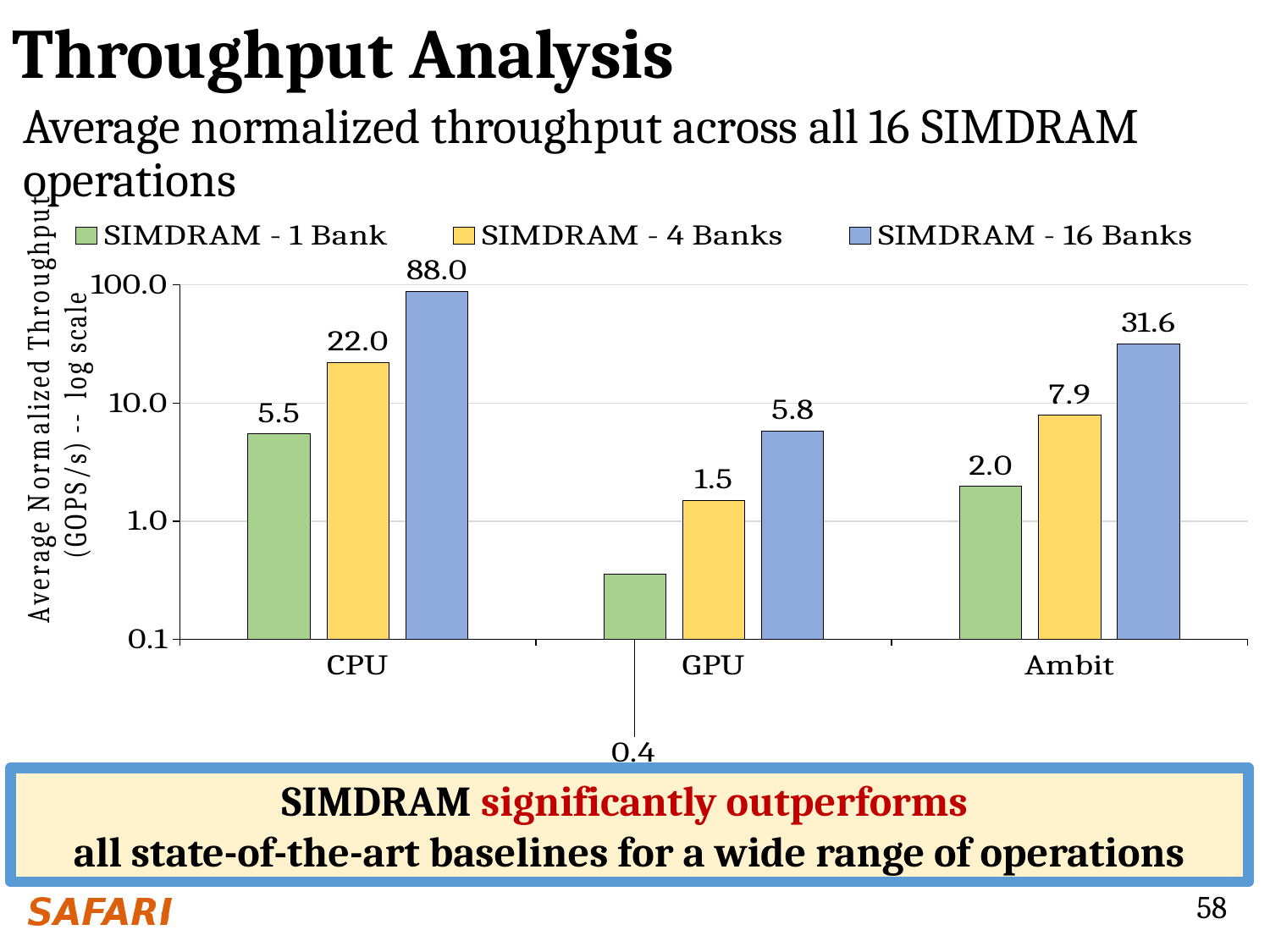
How many categories are shown on the x axis? 3 What is the value for SIMDRAM - 16 Banks for CPU? 88.0 What kind of chart is shown on the slide? bar chart Is the SIMDRAM - 1 Bank value for GPU greater or less than 1.0? less What is the difference between the SIMDRAM - 16 Banks value for CPU and for Ambit? 56.4 Which category has the highest SIMDRAM - 16 Banks value? CPU What is the value for SIMDRAM - 1 Bank for GPU? 0.4 How many series does the legend list? 3 What is the value for SIMDRAM - 4 Banks for Ambit? 7.9 What is the y-axis label of the chart? Average Normalized Throughput (GOPS/s) -- log scale Which is larger: the SIMDRAM - 4 Banks value for CPU or the SIMDRAM - 16 Banks value for Ambit? SIMDRAM - 16 Banks for Ambit Which category has the lowest SIMDRAM - 1 Bank value? GPU